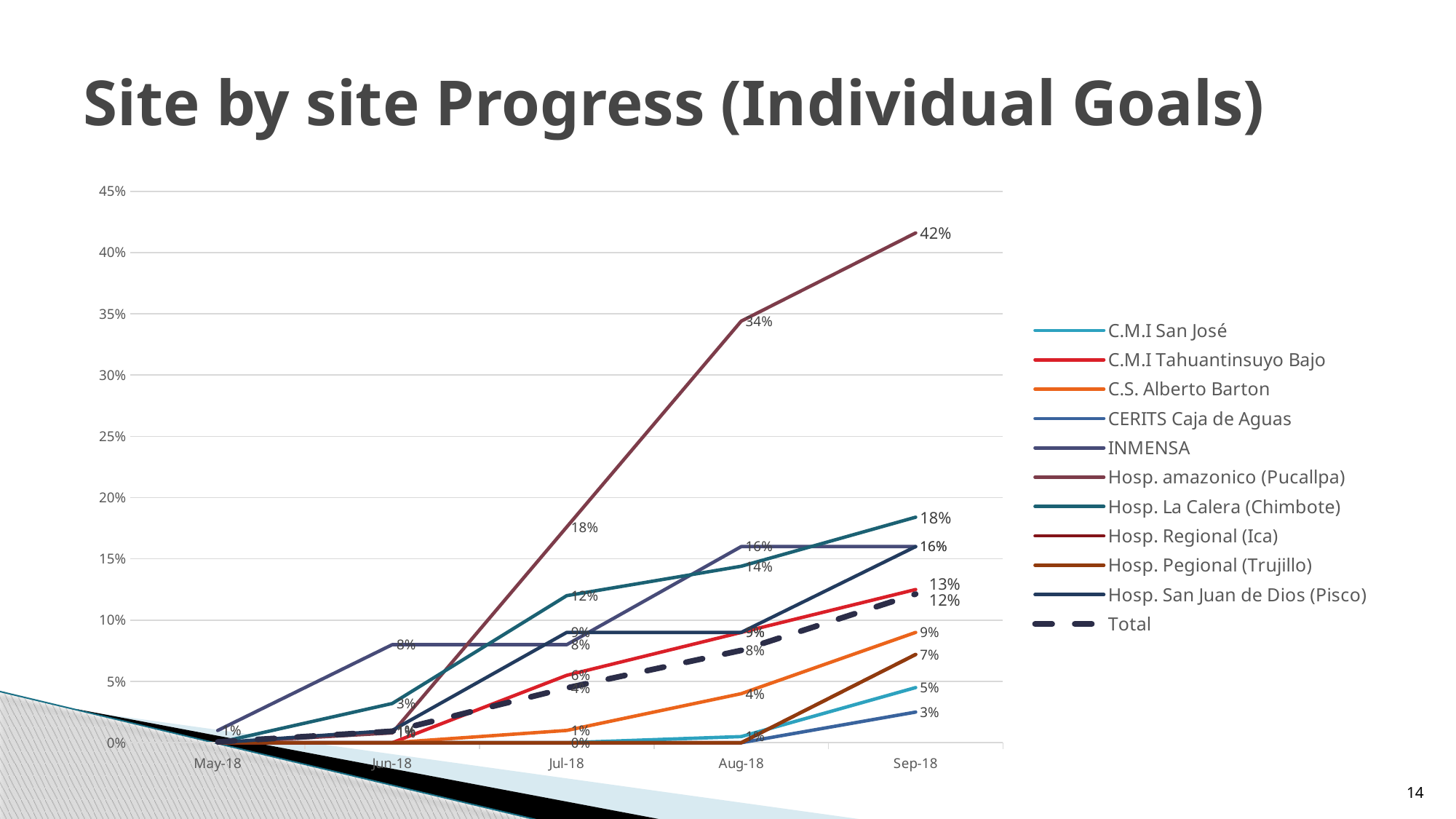
What is the Total value in Sep-18? 12% What is the value for Hosp. La Calera (Chimbote) in Sep-18? 18% Which site has the highest value in Sep-18? Hosp. amazonico (Pucallpa) How many series does the legend list? 11 How many months are shown on the x axis? 5 What is the value for Hosp. amazonico (Pucallpa) in Aug-18? 34% What type of chart is shown on the slide? line chart By how many percentage points did Hosp. amazonico (Pucallpa) increase from Aug-18 to Sep-18? 8 percentage points Is the value for Hosp. amazonico (Pucallpa) in Sep-18 greater or less than 40%? greater Which is larger in Sep-18: Hosp. La Calera (Chimbote) or C.S. Alberto Barton? Hosp. La Calera (Chimbote) Which series is drawn with a dashed line in the legend? Total What is the value for Hosp. amazonico (Pucallpa) in Sep-18? 42%